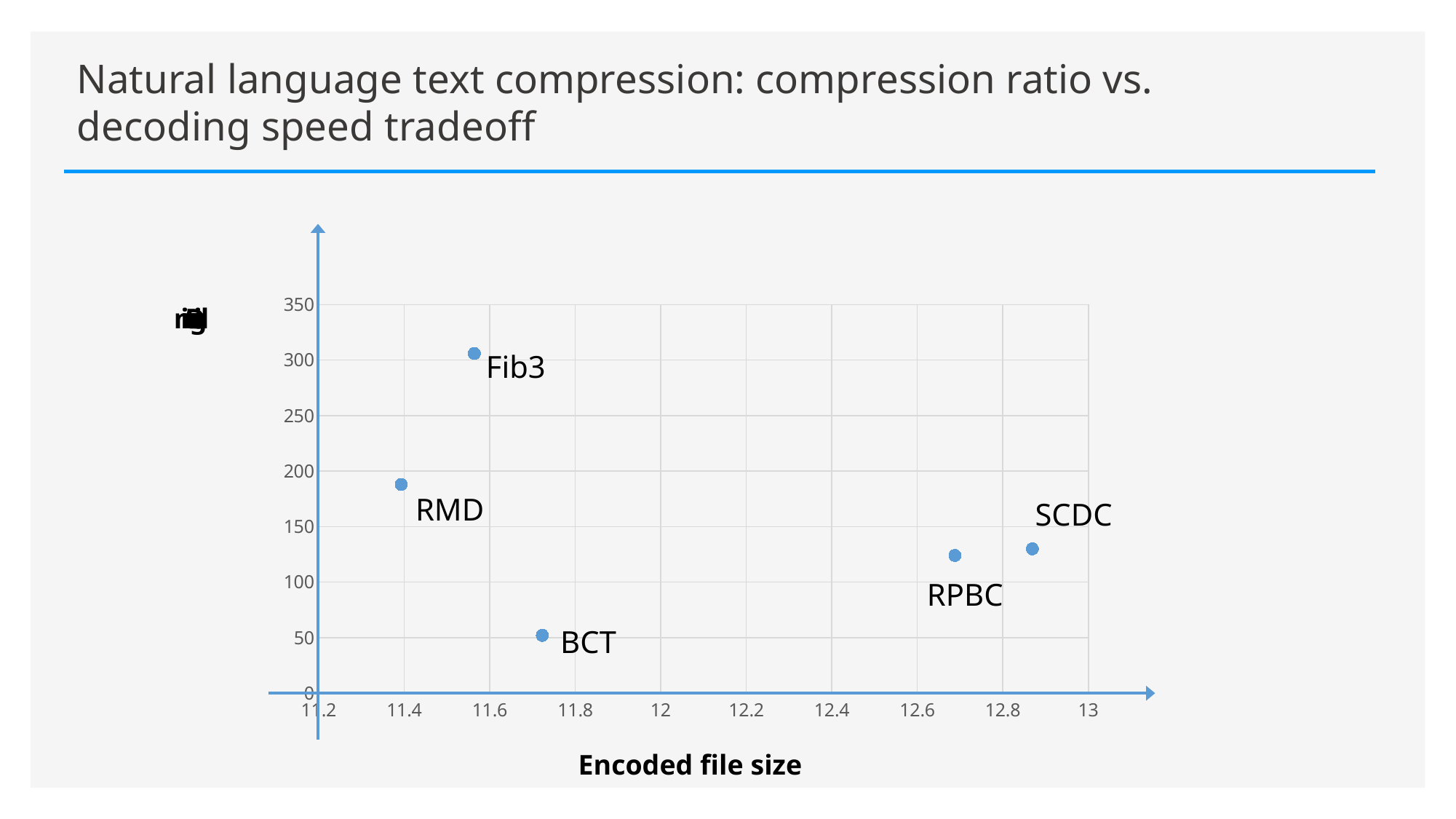
How many labeled data points are plotted on the chart? 5 Which labeled point has the largest encoded file size (furthest right on the x axis)? SCDC What is the title of the horizontal axis? Encoded file size Is the vertical-axis value for Fib3 greater or less than 250? greater Which labeled point has the smallest encoded file size (furthest left on the x axis)? RMD Is the vertical-axis value for BCT greater or less than 100? less Which labeled point has the highest value on the vertical axis? Fib3 Which labeled point has the lowest value on the vertical axis? BCT What kind of chart is shown on the slide? scatter chart Is the encoded file size for SCDC greater or less than 12.8? greater Which has a higher vertical-axis value, Fib3 or RMD? Fib3